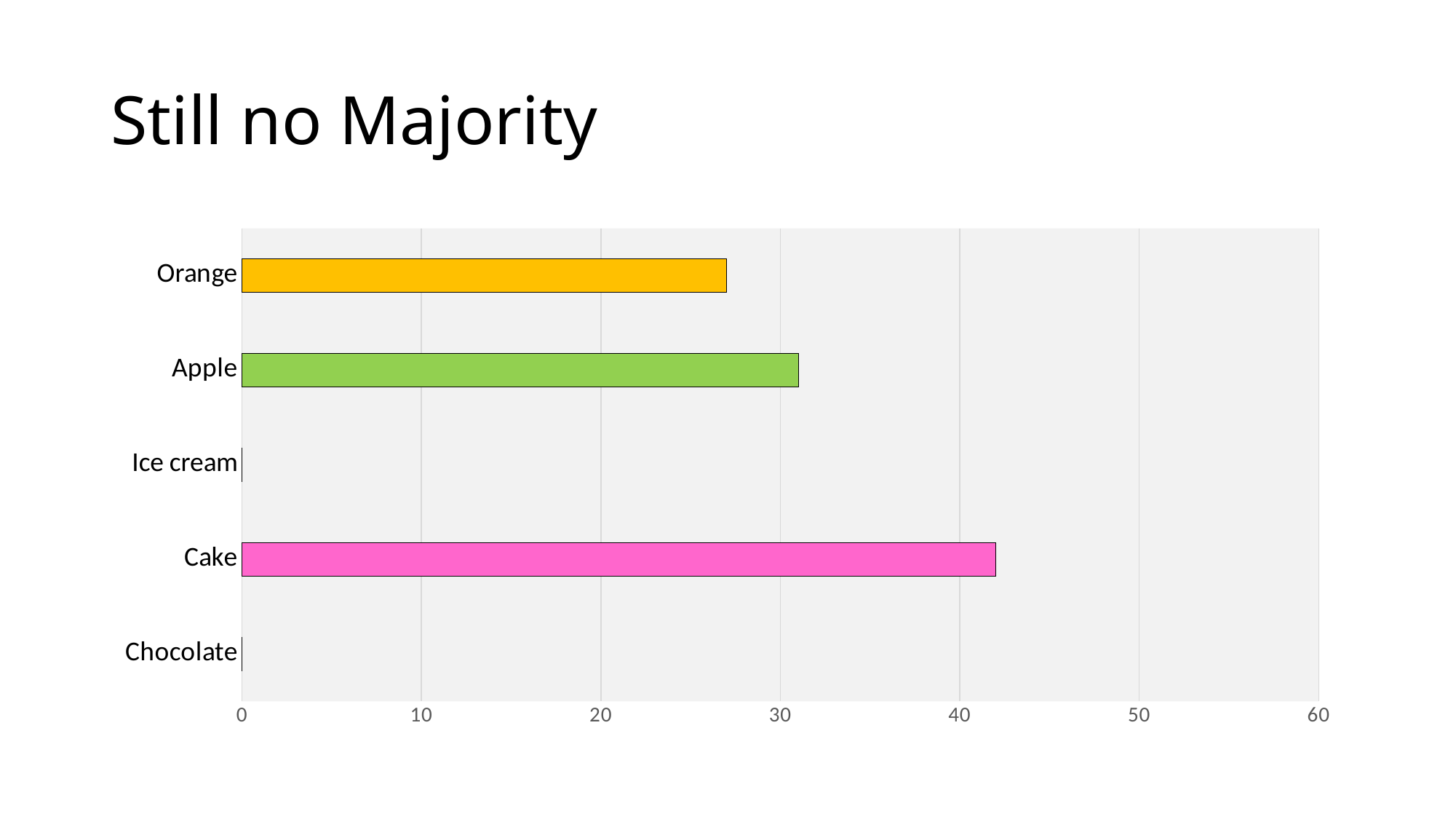
Is the value for Cake greater or less than 50? less What is the value for Ice cream? 0 Is the value for Orange greater or less than 30? less Which is larger, the value for Cake or the value for Apple? Cake Which category has the highest value? Cake What kind of chart is shown on the slide? bar chart Which is larger, the value for Apple or the value for Orange? Apple How many categories are shown on the chart? 5 What is the value for Chocolate? 0 What is the title of the slide? Still no Majority Is the value for Apple greater or less than 30? greater